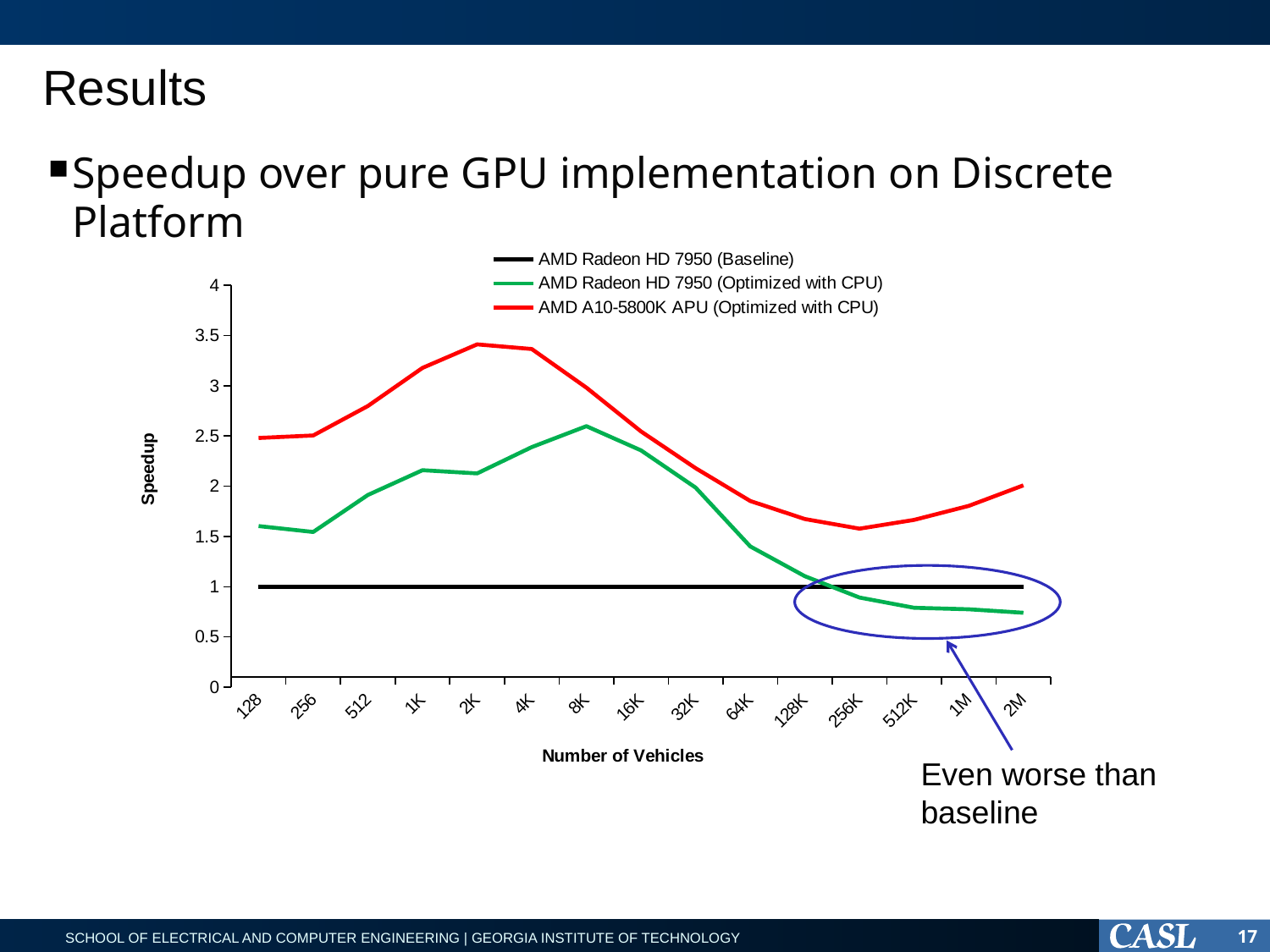
What is the speedup value of the AMD Radeon HD 7950 (Baseline) series? 1 At which number of vehicles does the AMD A10-5800K APU (Optimized with CPU) series reach its lowest speedup? 256K What is the title of the x axis? Number of Vehicles How many series does the legend list? 3 At which number of vehicles does the AMD Radeon HD 7950 (Optimized with CPU) series reach its highest speedup? 8K Does the speedup of the AMD A10-5800K APU (Optimized with CPU) series rise or fall from 2K to 256K vehicles? fall What kind of chart is shown on the slide? line chart At which number of vehicles does the AMD A10-5800K APU (Optimized with CPU) series reach its highest speedup? 2K Is the speedup for the AMD A10-5800K APU (Optimized with CPU) series at 2K vehicles greater or less than 3? greater Is the speedup for the AMD Radeon HD 7950 (Optimized with CPU) series at 2M vehicles greater or less than 1? less At 8K vehicles, which series has the higher speedup: AMD A10-5800K APU (Optimized with CPU) or AMD Radeon HD 7950 (Optimized with CPU)? AMD A10-5800K APU (Optimized with CPU) How many vehicle-count categories are shown on the x axis? 15